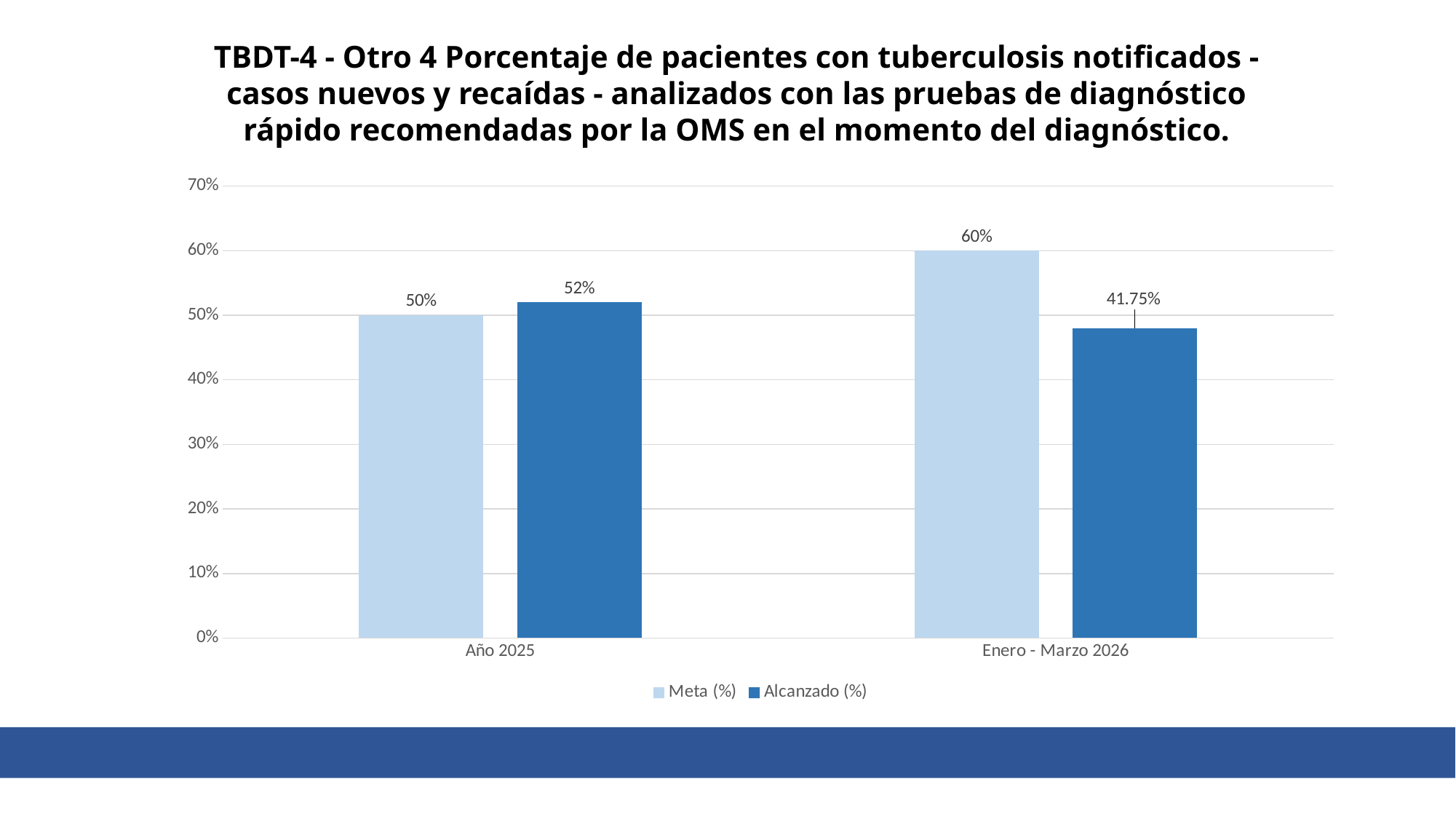
What is the Alcanzado (%) value labelled for Enero - Marzo 2026? 41.75% What is the Meta (%) value for Año 2025? 50% For Año 2025, which is larger: Meta (%) or Alcanzado (%)? Alcanzado (%) What is the Meta (%) value for Enero - Marzo 2026? 60% How many categories are shown on the x axis? 2 Which category has the highest Meta (%) value? Enero - Marzo 2026 For Enero - Marzo 2026, which is larger: Meta (%) or Alcanzado (%)? Meta (%) What is the difference between the Alcanzado (%) and Meta (%) values for Año 2025? 2% Which category has the lowest Alcanzado (%) value? Enero - Marzo 2026 Is the Meta (%) value for Enero - Marzo 2026 greater or less than 50%? greater How many series does the legend list? 2 What is the Alcanzado (%) value for Año 2025? 52%